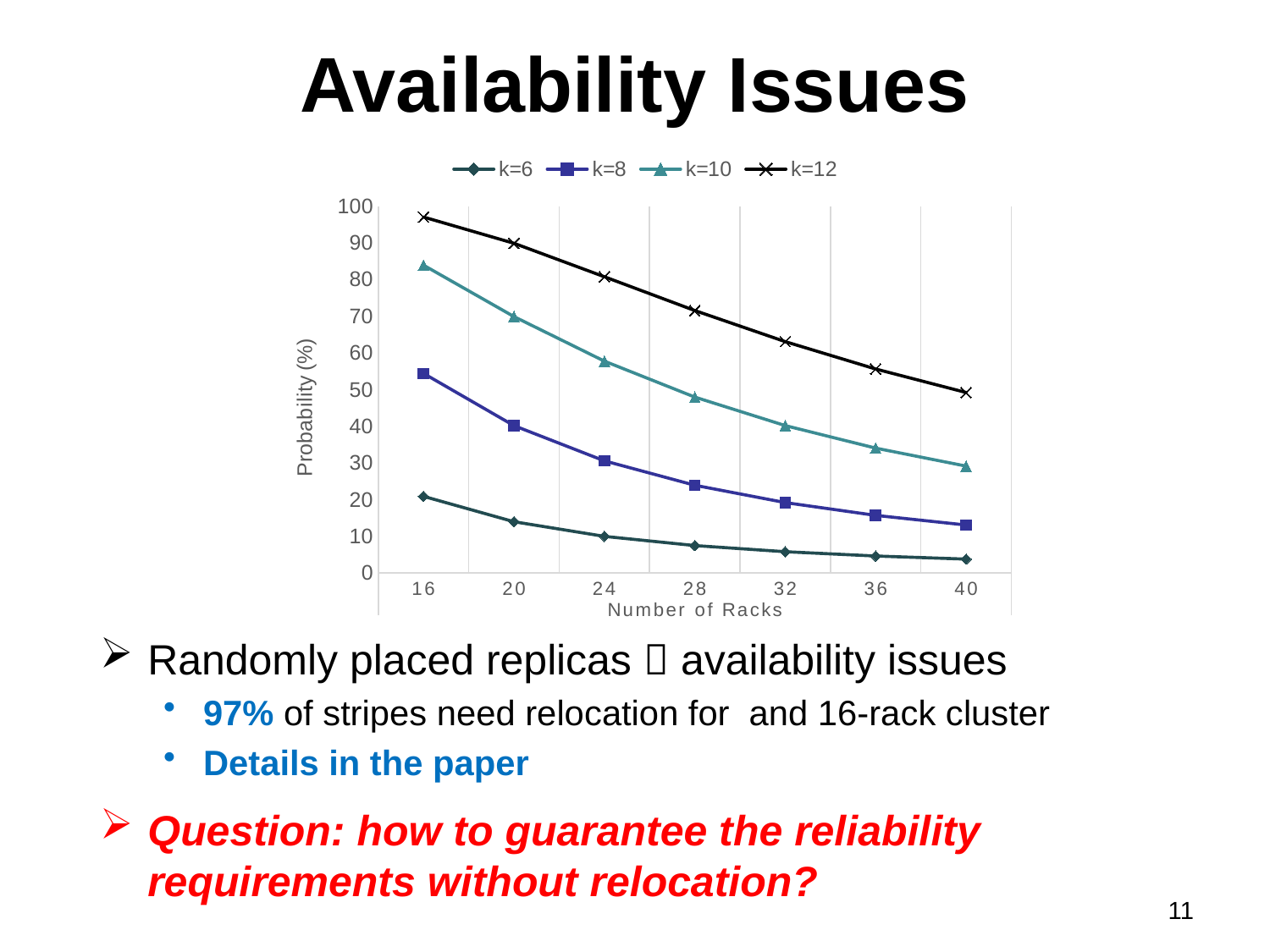
Which series has the highest probability at 16 racks? k=12 Is the value for k=10 at 16 racks greater or less than 80? greater What is the label of the x axis? Number of Racks How many series does the chart legend list? 4 Is the value for k=8 at 40 racks greater or less than 20? less Is the value for k=6 at 40 racks greater or less than 10? less Which series has the lowest probability at 40 racks? k=6 How many rack counts are plotted along the x axis? 7 Does the probability for k=12 rise or fall as the number of racks increases? fall What kind of chart is shown on the slide? line chart At 32 racks, which is larger: the value for k=10 or the value for k=8? k=10